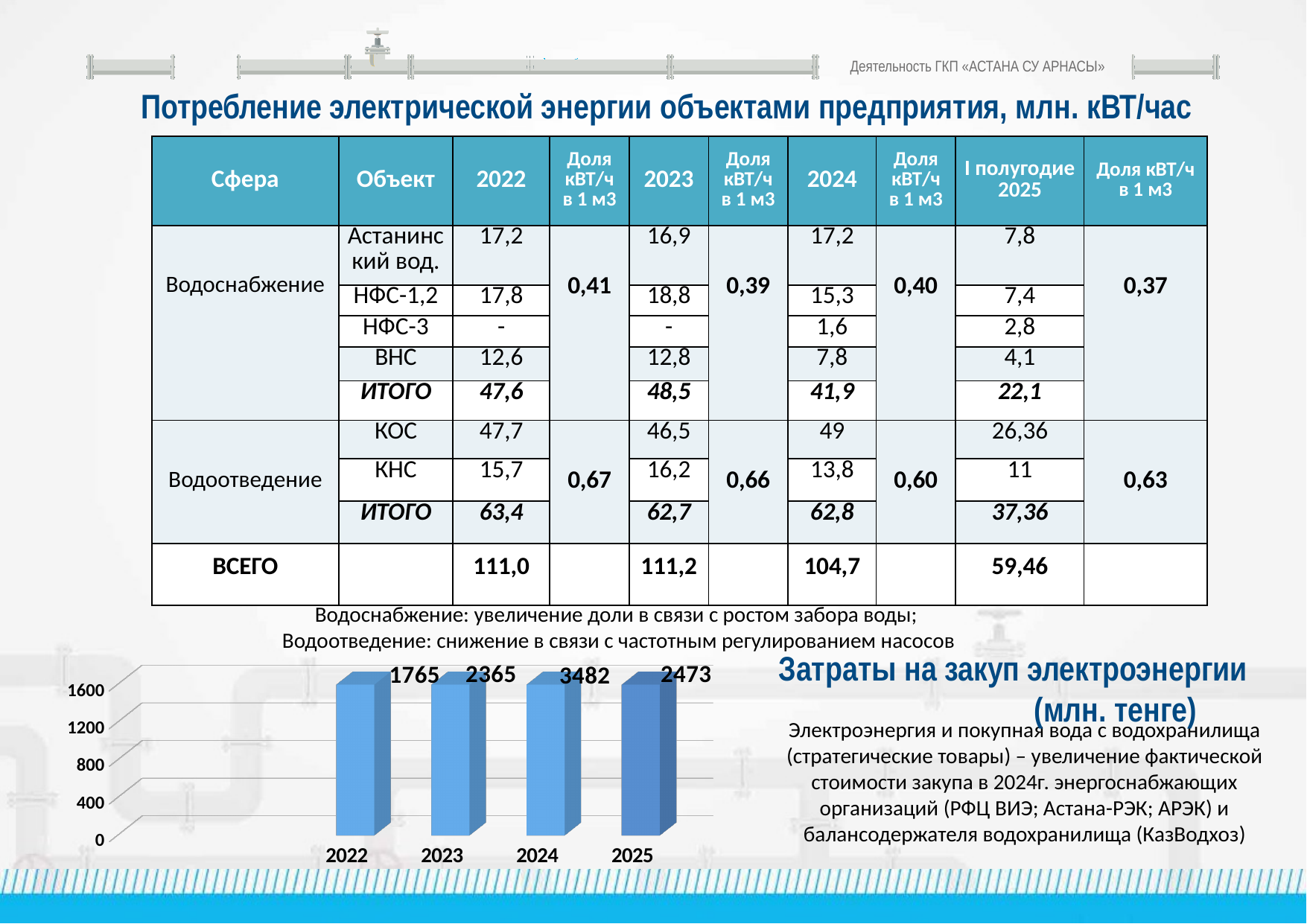
What is the value for 2025 in the chart 'Затраты на закуп электроэнергии (млн. тенге)'? 2473 How many years are shown in the chart 'Затраты на закуп электроэнергии (млн. тенге)'? 4 In the chart 'Затраты на закуп электроэнергии (млн. тенге)', is the value for 2022 greater or less than 1200? greater In the chart 'Затраты на закуп электроэнергии (млн. тенге)', what is the difference between the values for 2024 and 2025? 1009 In the chart 'Затраты на закуп электроэнергии (млн. тенге)', what is the difference between the values for 2023 and 2022? 600 What is the value for 2022 in the chart 'Затраты на закуп электроэнергии (млн. тенге)'? 1765 What is the value for 2024 in the chart 'Затраты на закуп электроэнергии (млн. тенге)'? 3482 In the chart 'Затраты на закуп электроэнергии (млн. тенге)', which year has the highest value? 2024 In the chart 'Затраты на закуп электроэнергии (млн. тенге)', which year has the lowest value? 2022 In the chart 'Затраты на закуп электроэнергии (млн. тенге)', how do the values change from 2022 to 2024? they rise What kind of chart is 'Затраты на закуп электроэнергии (млн. тенге)'? bar chart In the chart 'Затраты на закуп электроэнергии (млн. тенге)', which is larger: the value for 2023 or the value for 2025? 2025